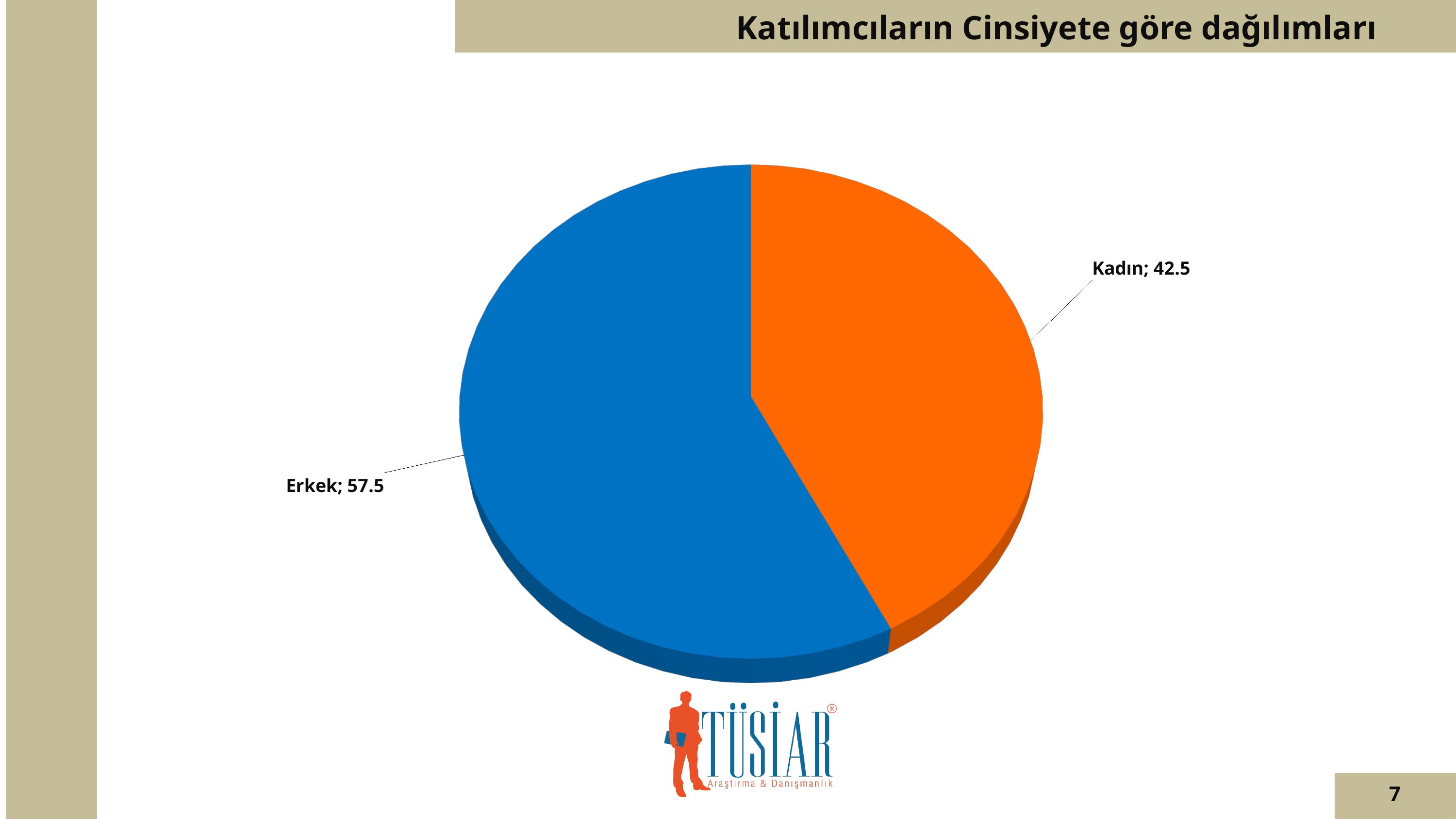
Which category has the largest slice? Erkek Which category has the smallest slice? Kadın What is the difference between the values for Erkek and Kadın? 15 What is the value for Kadın? 42.5 What is the total of the two slice values? 100 Which is larger, the value for Erkek or the value for Kadın? Erkek What is the value for Erkek? 57.5 What colour is the Erkek slice? blue How many slices does the pie chart have? 2 What is the title of the chart? Katılımcıların Cinsiyete göre dağılımları What kind of chart is shown on the slide? pie chart